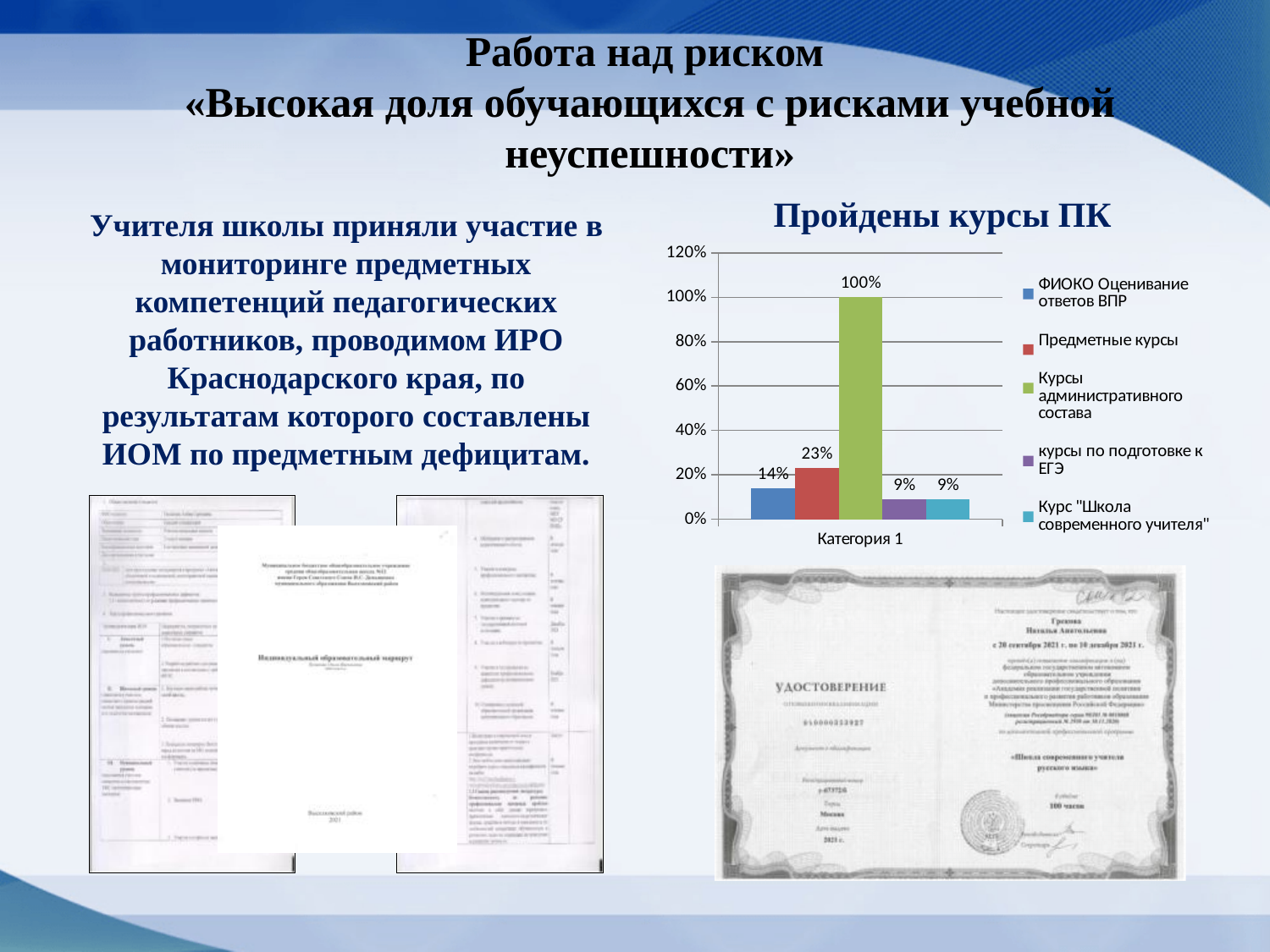
What is the category label shown on the x axis of the chart? Категория 1 What is the value for the series "курсы по подготовке к ЕГЭ" in the chart? 9% What is the value for the series "ФИОКО Оценивание ответов ВПР" in the chart? 14% How many series does the legend of the chart "Пройдены курсы ПК" list? 5 What kind of chart is shown on the slide? Bar chart What is the value for the series "Курсы административного состава" in the chart? 100% What is the value for the series "Предметные курсы" in the chart "Пройдены курсы ПК"? 23% What is the difference between the values for "Курсы административного состава" and "Предметные курсы"? 77% Which is larger in the chart: the value for "Предметные курсы" or the value for "ФИОКО Оценивание ответов ВПР"? Предметные курсы Which series has the highest value in the chart "Пройдены курсы ПК"? Курсы административного состава What is the title of the chart on the slide? Пройдены курсы ПК What is the difference between the values for "Предметные курсы" and "ФИОКО Оценивание ответов ВПР"? 9%